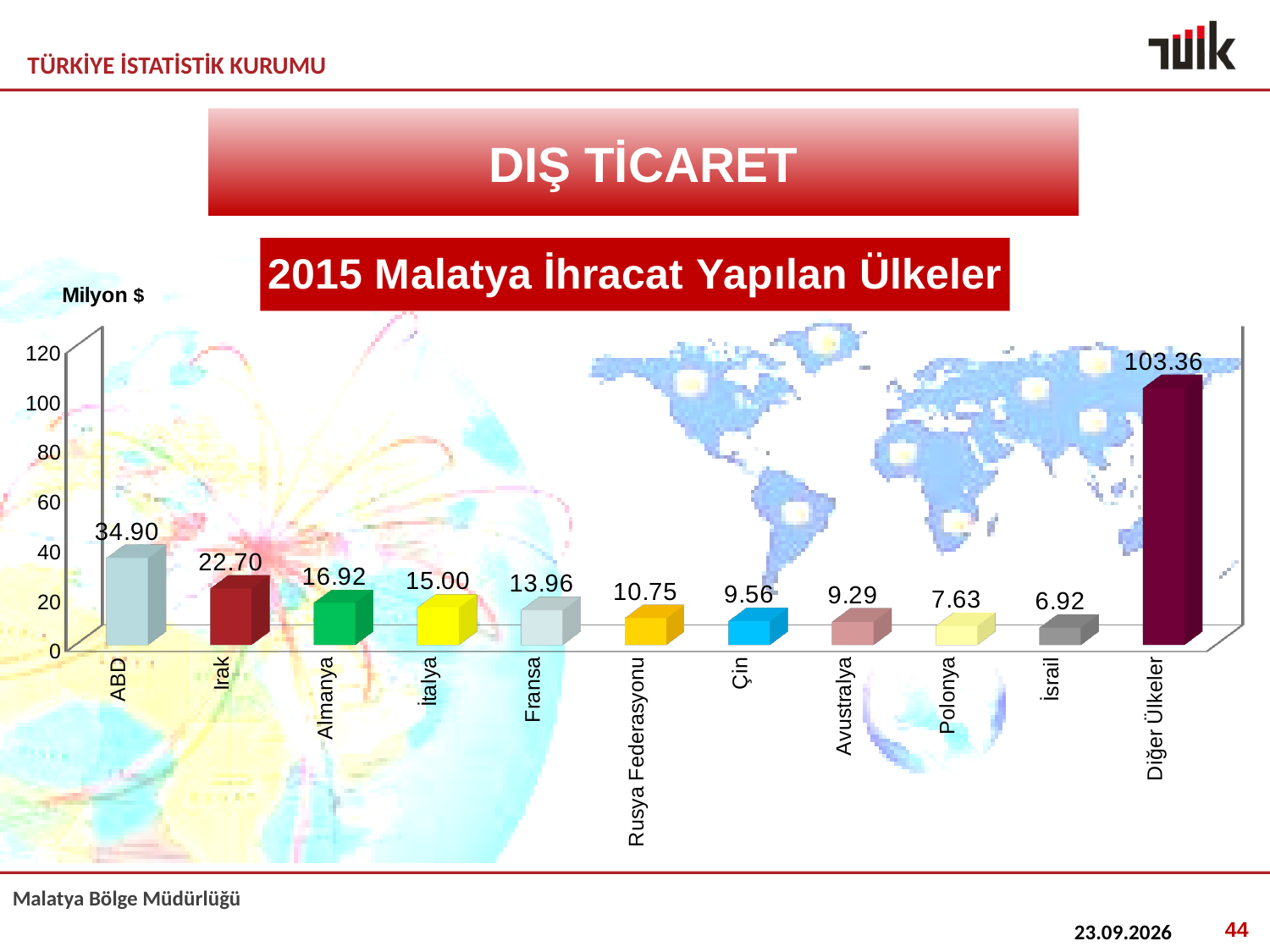
How many categories are shown on the x axis? 11 What is the difference between the values for ABD and Irak? 12.20 What kind of chart is shown on the slide? bar chart What is the title of the chart? 2015 Malatya İhracat Yapılan Ülkeler What is the value for Diğer Ülkeler? 103.36 Which category has the lowest value? İsrail What unit is shown above the y axis of the chart? Milyon $ Which category has the highest value? Diğer Ülkeler Which is larger, the value for Almanya or the value for Fransa? Almanya Is the value for Diğer Ülkeler greater or less than 100? greater What is the value for ABD? 34.90 What is the value for Rusya Federasyonu? 10.75